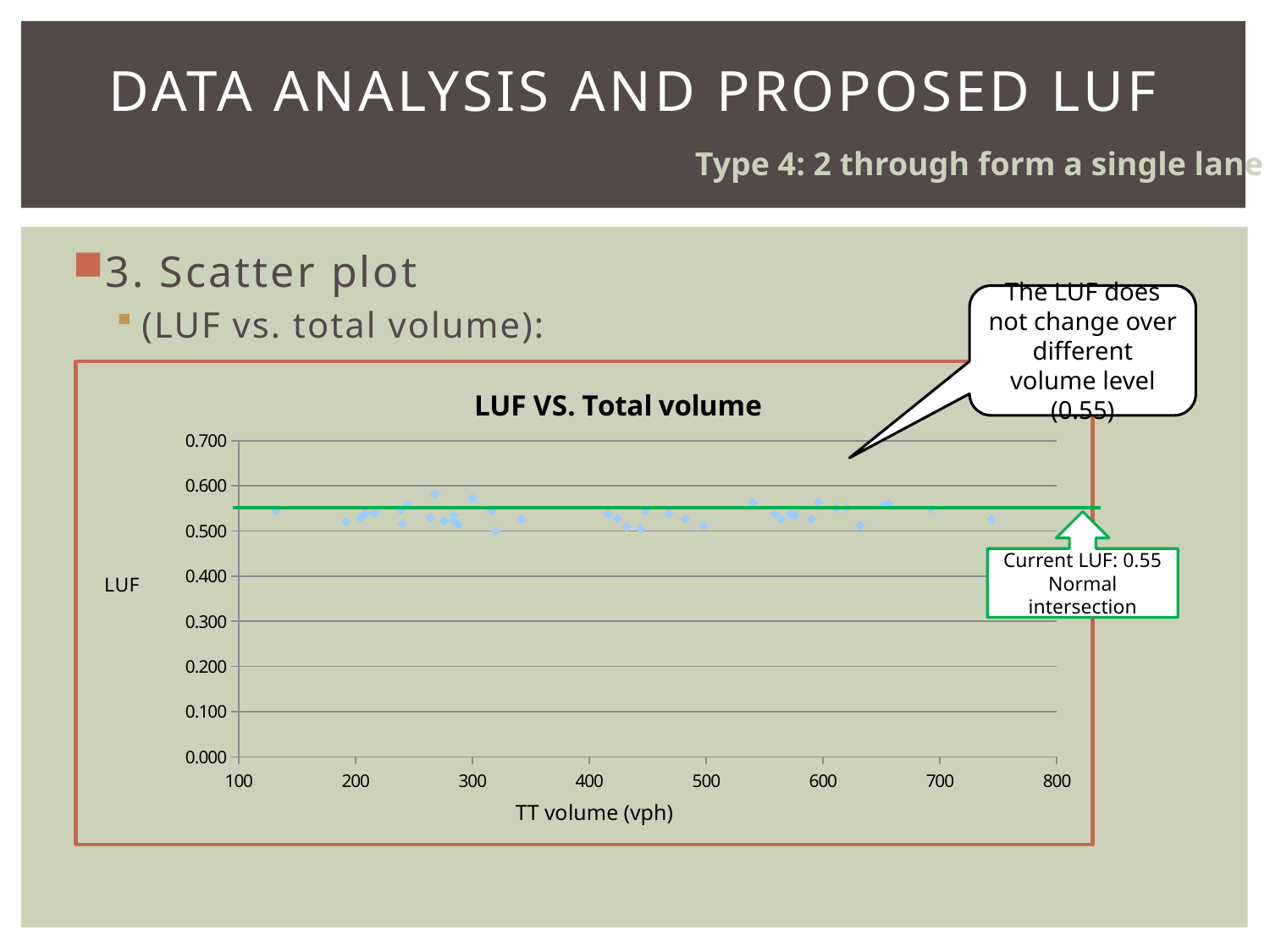
What is the title of the chart? LUF VS. Total volume Is the plotted LUF value at a TT volume of about 320 vph greater or less than 0.550? less What is the label of the x axis of the chart? TT volume (vph) What is the lowest TT volume tick shown on the x axis? 100 What kind of chart is shown on the slide? Scatter plot Are the plotted LUF values greater or less than 0.600 across the chart? less What is the highest TT volume tick shown on the x axis? 800 Do the LUF values rise, fall, or stay roughly flat as TT volume increases from 100 to 800 vph? Stay roughly flat Are the plotted LUF values greater or less than 0.400 across the chart? greater What is the highest value shown on the y axis of the chart? 0.700 What value does the green horizontal line on the chart represent, according to the annotation? 0.55